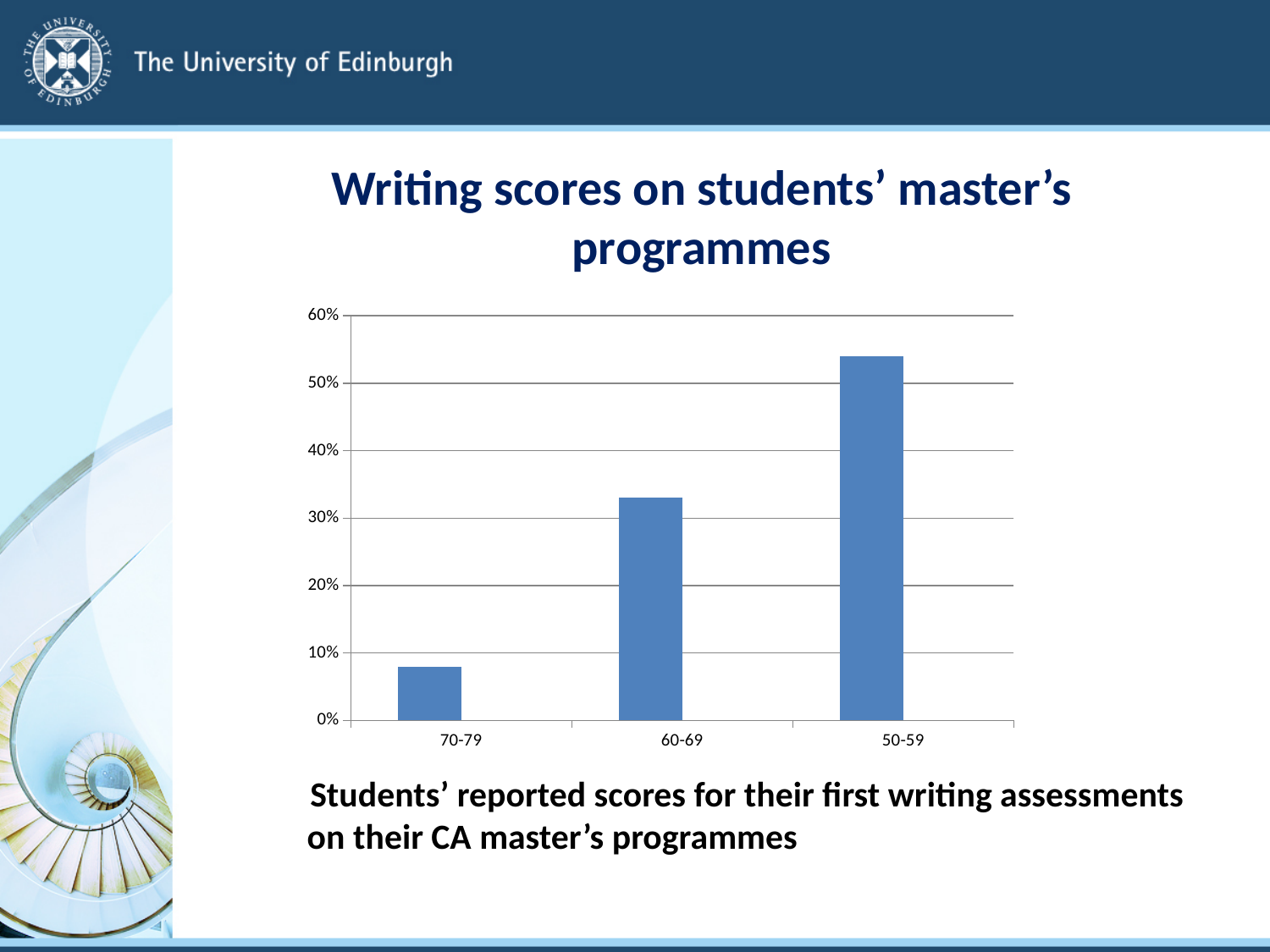
How many score bands are shown on the x axis of the chart? 3 Is the value for 50-59 greater or less than 50%? greater Is the value for 60-69 greater or less than 30%? greater Is the value for 60-69 greater or less than 40%? less Which score band has the highest bar? 50-59 Which is larger, the value for 50-59 or the value for 60-69? 50-59 Which score band has the lowest bar? 70-79 Which is larger, the value for 60-69 or the value for 70-79? 60-69 Do the bar values rise or fall moving from left to right along the x axis? rise What is the title of the chart on the slide? Writing scores on students' master's programmes What kind of chart is shown on the slide? bar chart